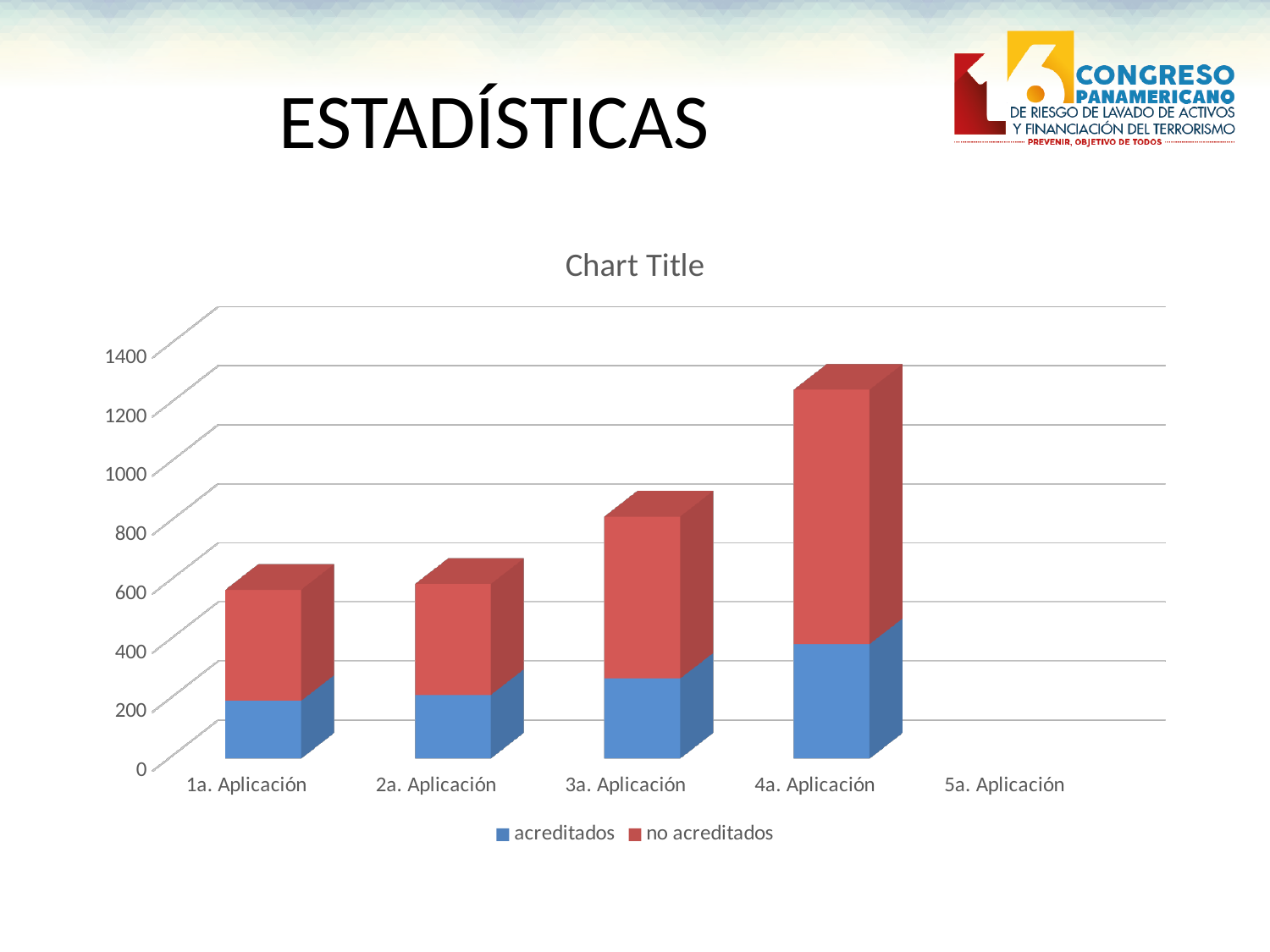
Is the total for 3a. Aplicación greater or less than 600? greater Is the acreditados value for 4a. Aplicación greater or less than 200? greater What are the two legend entries of the chart? acreditados, no acreditados Which has the larger total, 3a. Aplicación or 4a. Aplicación? 4a. Aplicación Is the total for 4a. Aplicación greater or less than 1000? greater How many stacked bars are actually plotted on the chart? 4 Which category has the highest total stacked bar? 4a. Aplicación What kind of chart is shown on the slide? bar chart How many categories are labelled on the x axis? 5 Do the stacked totals rise or fall from 1a. Aplicación to 4a. Aplicación? rise How many series does the legend list? 2